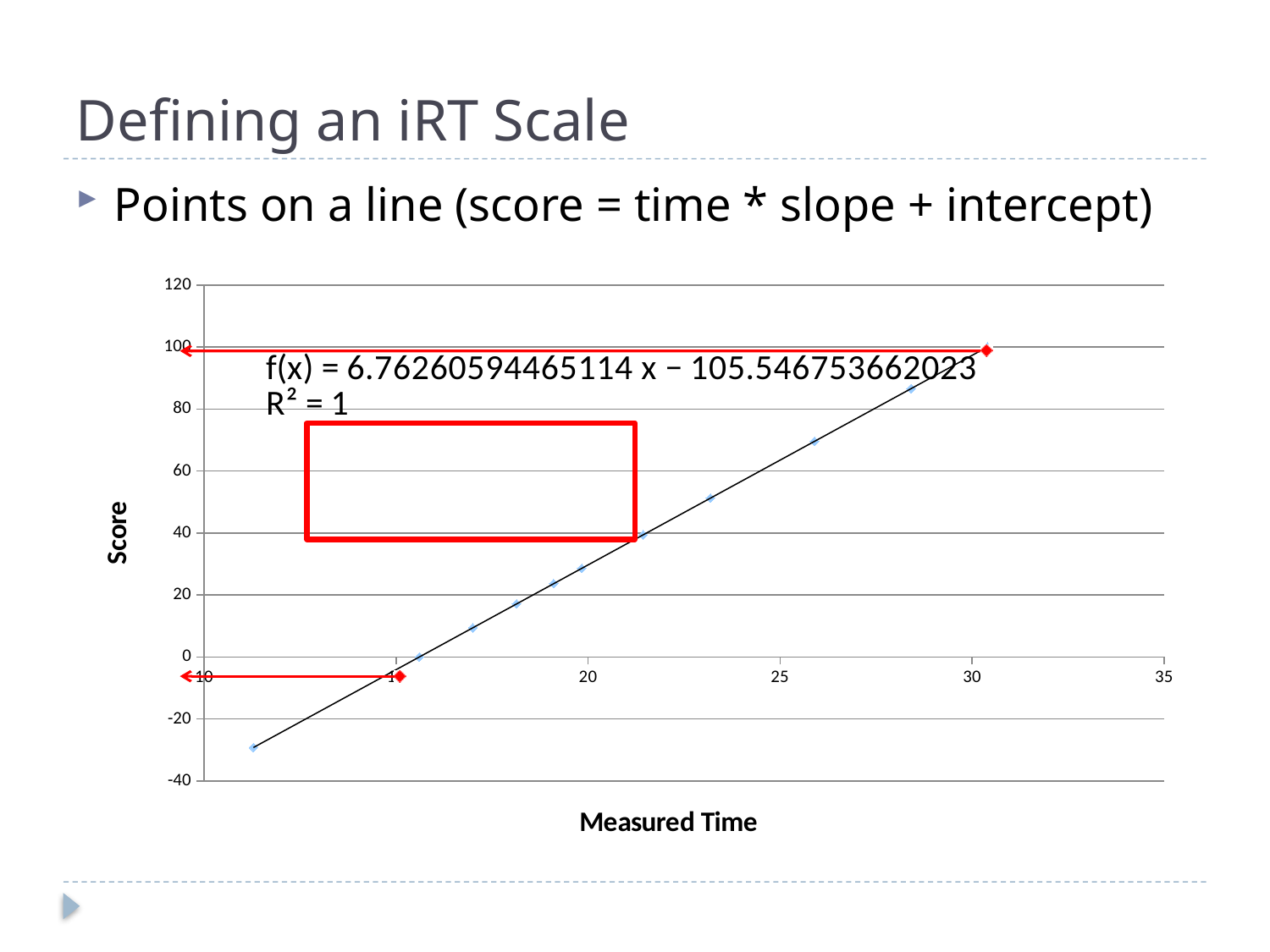
What R² value is shown for the trendline on the chart? R² = 1 Which plotted point has the higher score: the one at a Measured Time of about 23 or the one at about 28? The one at about 28 What is the intercept of the trendline equation shown on the chart? −105.546753662023 Is the score for the point at a Measured Time of about 26 greater or less than 60? greater Do the plotted scores rise or fall as Measured Time increases? Rise What is the title of the y axis of the chart? Score What is the highest value shown on the y axis of the chart? 120 Is the score for the highest plotted point (at a Measured Time of about 30) greater or less than 80? greater What kind of chart is shown on the slide? Scatter chart What is the title of the x axis of the chart? Measured Time What is the slope of the trendline equation shown on the chart? 6.76260594465114 Is the score for the lowest plotted point (at a Measured Time of about 11) greater or less than -20? less